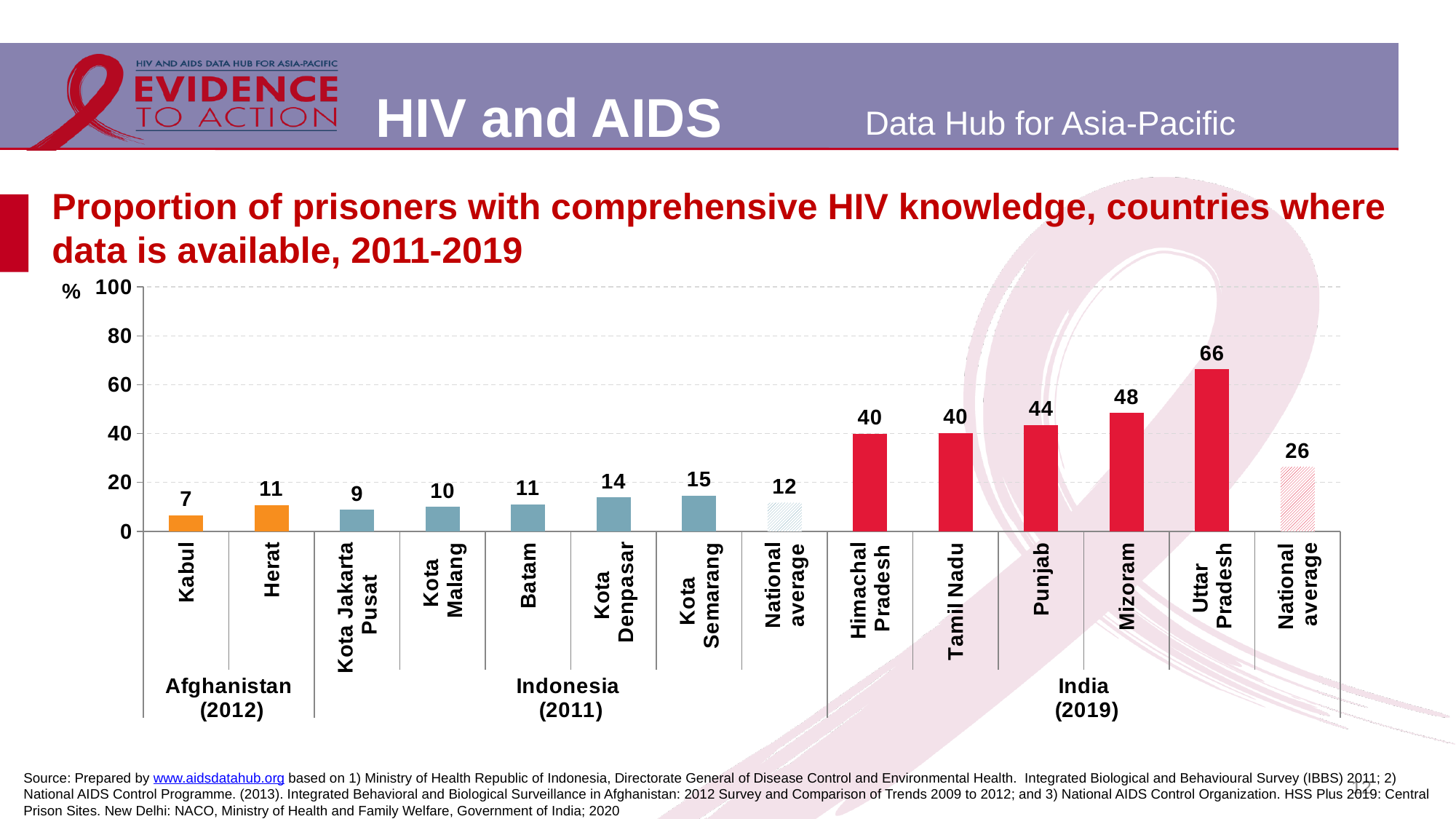
What is the national average shown for India (2019)? 26 Which three countries are grouped along the x axis of the chart? Afghanistan, Indonesia, India Which category has the highest value? Uttar Pradesh What is the value for Uttar Pradesh? 66 What is the national average shown for Indonesia (2011)? 12 Which category has the lowest value? Kabul What is the difference between the values for Mizoram and Punjab? 4 What is the value for Kabul? 7 What kind of chart is shown on the slide? Bar chart Is the value for Himachal Pradesh greater or less than 20? greater Which is larger, the value for Kota Semarang or the value for Kota Denpasar? Kota Semarang How many bars are plotted in the chart? 14